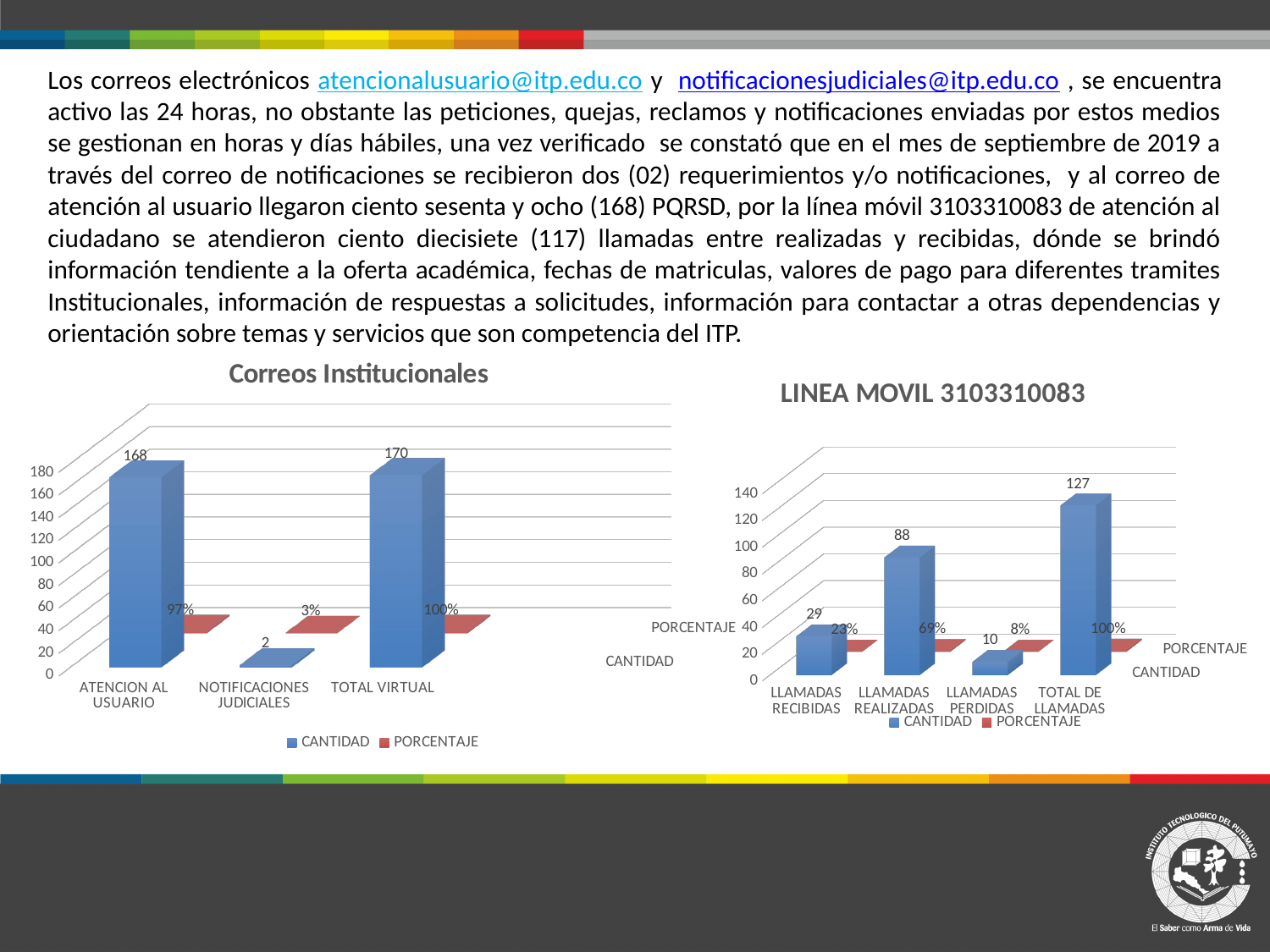
In the 'LINEA MOVIL 3103310083' chart, which has a larger CANTIDAD value: LLAMADAS RECIBIDAS or LLAMADAS PERDIDAS? LLAMADAS RECIBIDAS In the 'Correos Institucionales' chart, how many series does the legend list? 2 In the 'Correos Institucionales' chart, which category has the lowest CANTIDAD value? NOTIFICACIONES JUDICIALES In the 'LINEA MOVIL 3103310083' chart, what is the PORCENTAJE value for LLAMADAS PERDIDAS? 8% In the 'LINEA MOVIL 3103310083' chart, what is the difference between the CANTIDAD values for LLAMADAS REALIZADAS and LLAMADAS RECIBIDAS? 59 What type of chart is the 'Correos Institucionales' chart? Bar chart In the 'Correos Institucionales' chart, what is the difference between the CANTIDAD values for TOTAL VIRTUAL and ATENCION AL USUARIO? 2 In the 'Correos Institucionales' chart, what is the CANTIDAD value for ATENCION AL USUARIO? 168 How many categories are shown in the 'LINEA MOVIL 3103310083' chart? 4 In the 'LINEA MOVIL 3103310083' chart, which category has the highest CANTIDAD value? TOTAL DE LLAMADAS In the 'LINEA MOVIL 3103310083' chart, what is the CANTIDAD value for LLAMADAS REALIZADAS? 88 In the 'Correos Institucionales' chart, what is the PORCENTAJE value for NOTIFICACIONES JUDICIALES? 3%